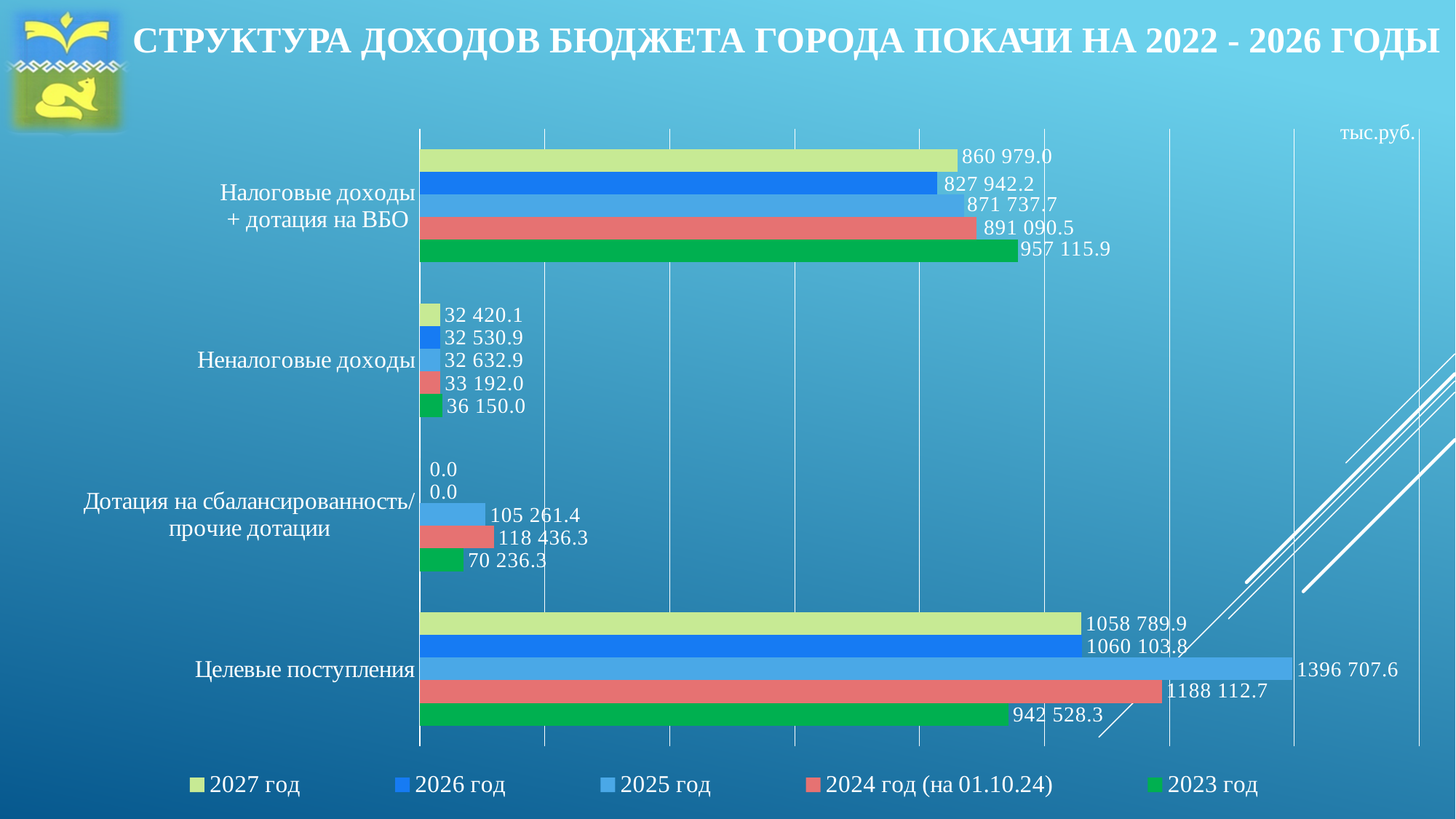
How many series does the legend list? 5 What is the value for 2025 год in the category Целевые поступления? 1396 707.6 Which year has the highest value in the category Целевые поступления? 2025 год What unit is indicated in the top right corner of the chart? тыс.руб. Which year has the lowest value in the category Налоговые доходы + дотация на ВБО? 2026 год In the category Дотация на сбалансированность/прочие дотации, which is larger: the value for 2025 год or for 2023 год? 2025 год What is the difference between the 2023 год and 2027 год values in the category Налоговые доходы + дотация на ВБО? 96 136.9 How many categories are shown on the chart? 4 What kind of chart is shown on the slide? Bar chart What is the value for 2023 год in the category Налоговые доходы + дотация на ВБО? 957 115.9 What is the value for 2024 год (на 01.10.24) in the category Дотация на сбалансированность/прочие дотации? 118 436.3 What is the value for 2027 год in the category Неналоговые доходы? 32 420.1